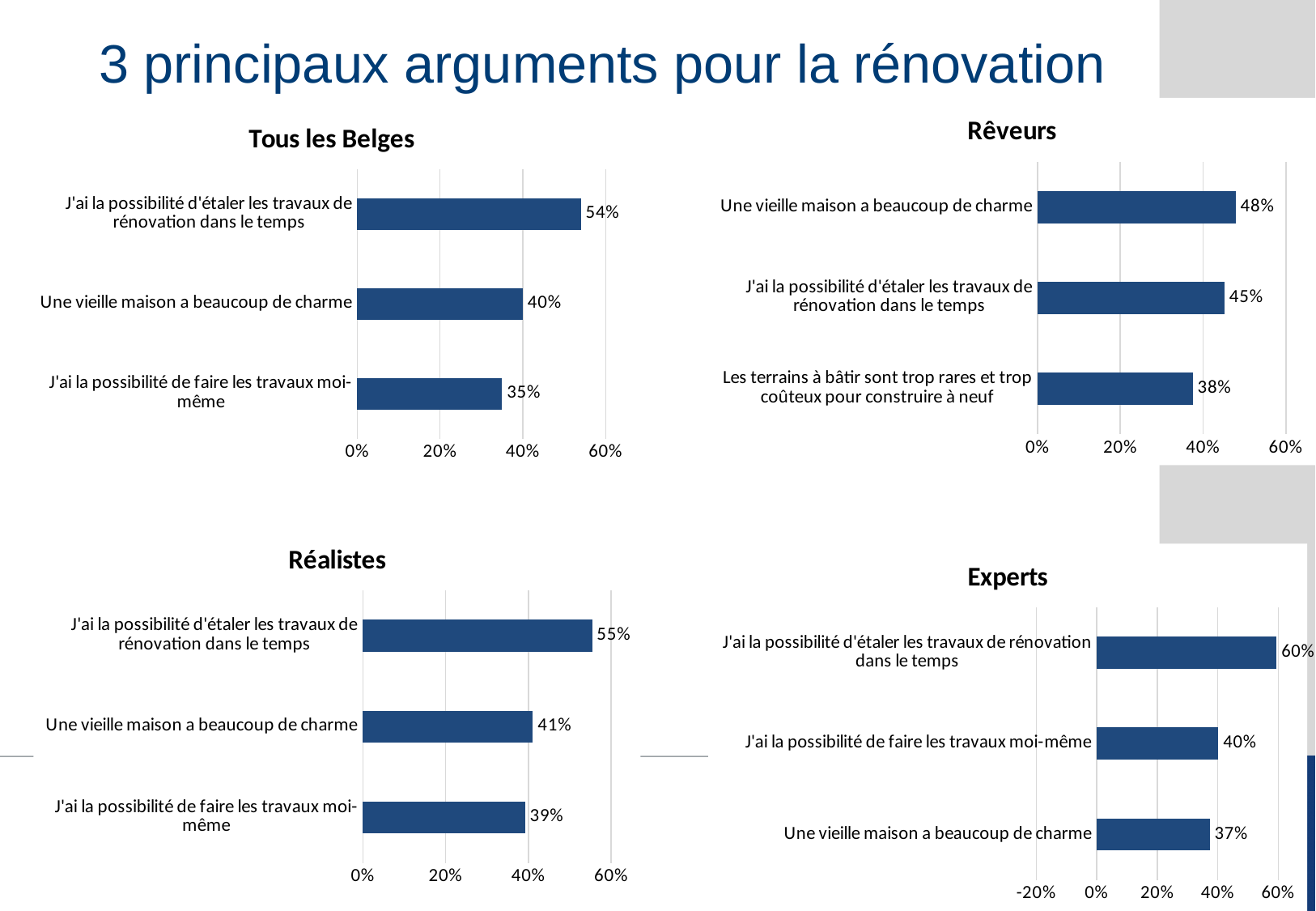
In the 'Experts' chart, what is the value for 'J'ai la possibilité de faire les travaux moi-même'? 40% In the 'Rêveurs' chart, is the value for 'J'ai la possibilité d'étaler les travaux de rénovation dans le temps' greater or less than 40%? greater In the 'Experts' chart, what is the difference between the highest and lowest values? 23% What kind of chart is the 'Tous les Belges' chart? Bar chart In the 'Rêveurs' chart, which category has the lowest value? Les terrains à bâtir sont trop rares et trop coûteux pour construire à neuf In the 'Réalistes' chart, which is larger: the value for 'Une vieille maison a beaucoup de charme' or 'J'ai la possibilité de faire les travaux moi-même'? Une vieille maison a beaucoup de charme In the 'Rêveurs' chart, what is the value for 'Une vieille maison a beaucoup de charme'? 48% In the 'Réalistes' chart, which category has the highest value? J'ai la possibilité d'étaler les travaux de rénovation dans le temps In the 'Tous les Belges' chart, what is the value for 'J'ai la possibilité d'étaler les travaux de rénovation dans le temps'? 54% How many categories are shown in the 'Experts' chart? 3 In the 'Tous les Belges' chart, what is the difference between the values for 'J'ai la possibilité d'étaler les travaux de rénovation dans le temps' and 'J'ai la possibilité de faire les travaux moi-même'? 19% How many charts are shown on the slide? 4